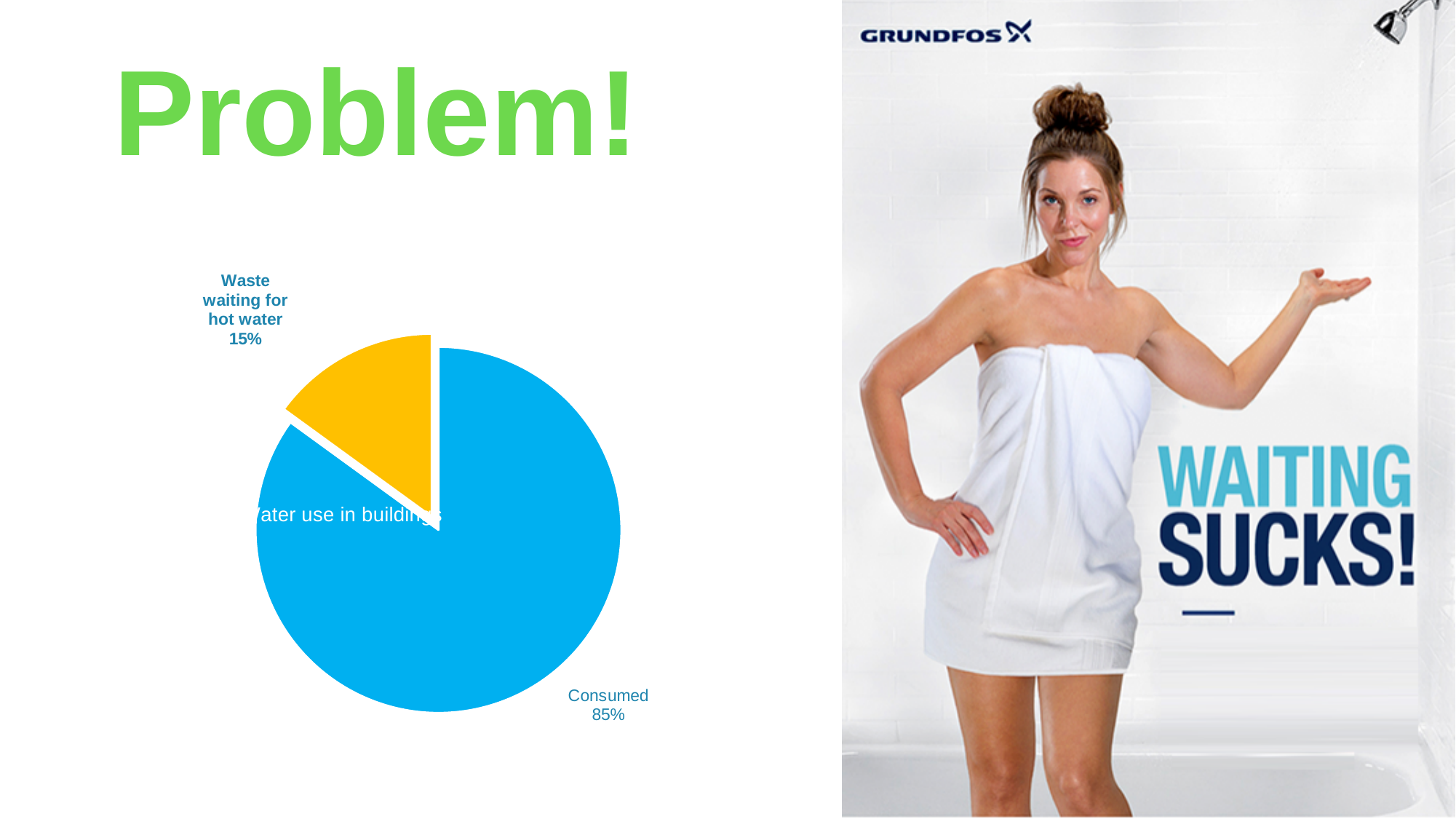
What percentage of water use in buildings is waste waiting for hot water? 15% Which slice of the pie chart is the smallest? Waste waiting for hot water Which slice of the pie chart is the largest? Consumed What is the title of the pie chart? Water use in buildings What share of the pie does the Consumed slice represent? 85% Which is larger: the Consumed slice or the Waste waiting for hot water slice? Consumed How many slices does the pie chart have? 2 What type of chart is shown on the slide? pie chart What percentage of water use in buildings is consumed? 85% What is the difference in percentage points between the Consumed slice and the Waste waiting for hot water slice? 70 What colour is the Waste waiting for hot water slice? yellow